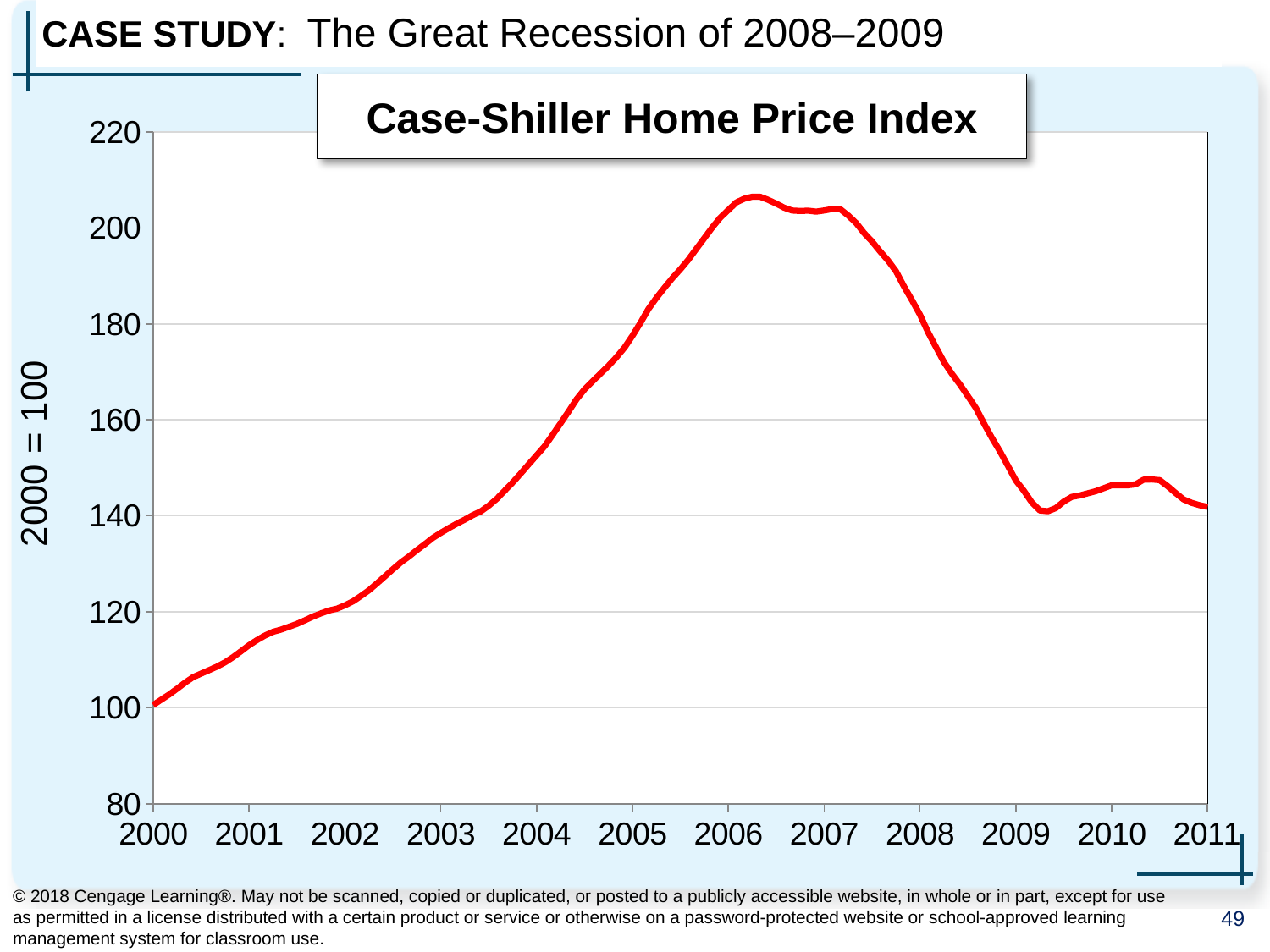
In which labeled year is the index at its lowest level? 2000 Is the value of the index at 2005 greater or less than 160? greater What is the value of the Case-Shiller Home Price Index at the start of 2000? 100 Is the value of the index at 2001 greater or less than 120? less In which labeled year does the index reach its highest level? 2006 What is the label on the vertical axis of the chart? 2000 = 100 Does the index rise or fall between 2007 and 2009? fall What is the title of the chart? Case-Shiller Home Price Index Is the value of the index at 2006 greater or less than 200? less What kind of chart is shown on the slide? line chart